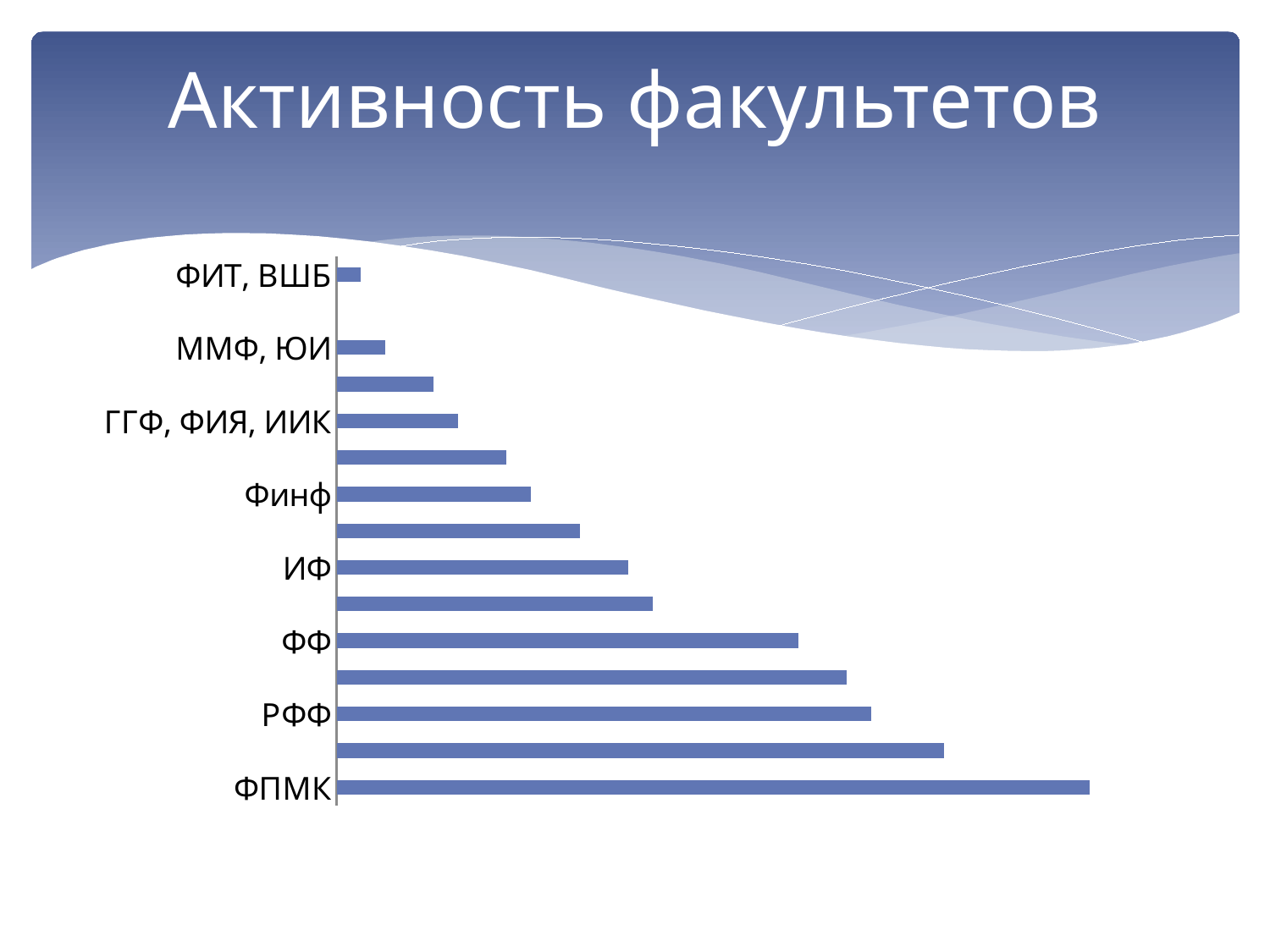
What is the title of the slide containing the chart? Активность факультетов Which has the larger value, ФФ or ФПМК? ФПМК What type of chart is shown on the slide? bar chart Do the bar lengths increase or decrease going from the top of the chart to the bottom? increase Which has the larger value, ММФ, ЮИ or Финф? Финф Which has the larger value, РФФ or ИФ? РФФ Which labeled category has the shortest bar? ФИТ, ВШБ Which labeled category has the longest bar? ФПМК What colour are the bars in the chart? blue